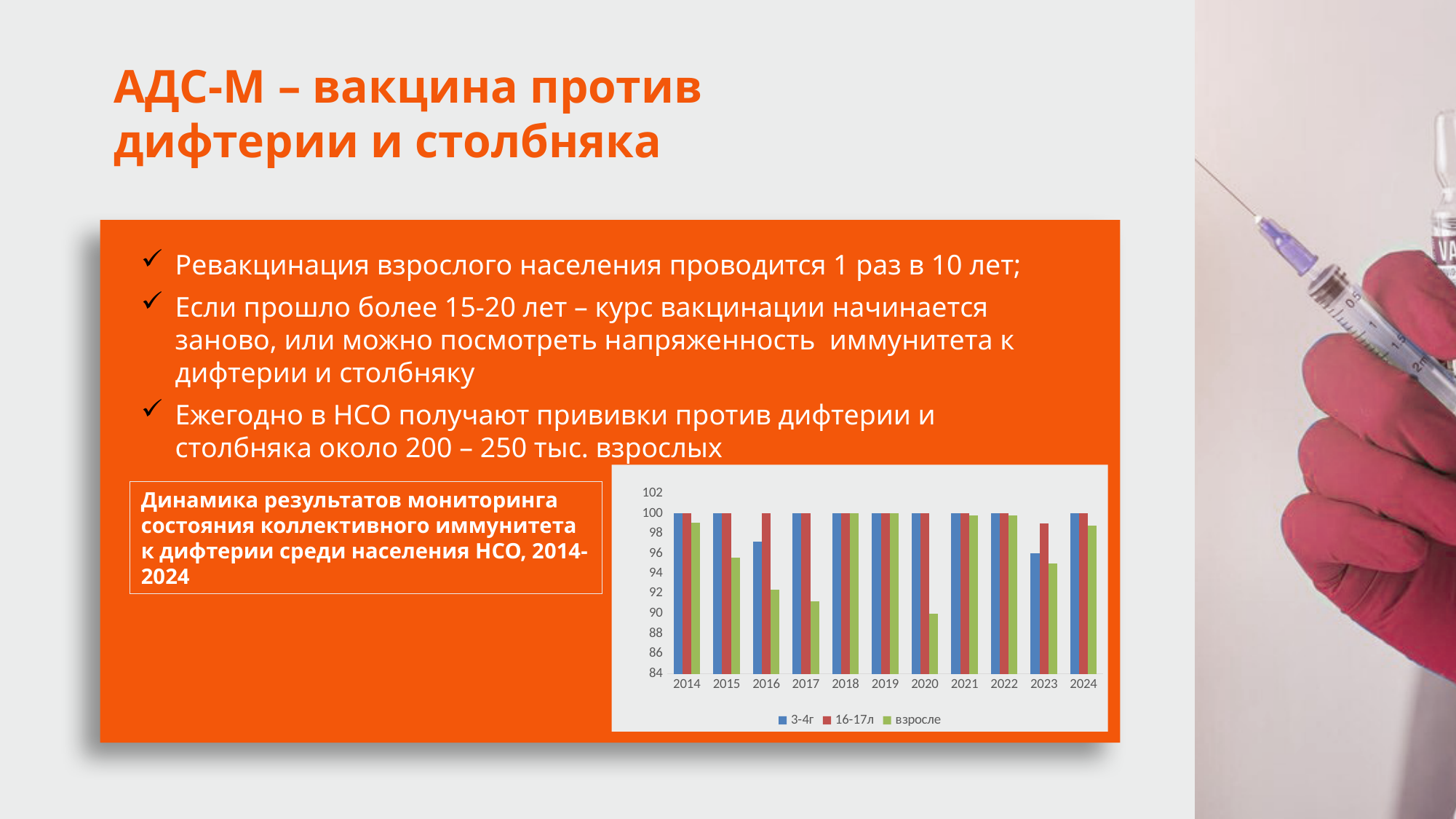
Is the value for 'взросле' in 2017 greater or less than 94? less Is the value for '3-4г' in 2023 greater or less than 98? less In 2015, which series has the smaller value: '16-17л' or 'взросле'? взросле Is the value for 'взросле' in 2020 greater or less than 92? less Which colour represents the 'взросле' series in the chart? green In 2016, which series has the larger value: '3-4г' or 'взросле'? 3-4г What kind of chart is shown on the slide? bar chart What are the series names listed in the chart legend? 3-4г, 16-17л, взросле How many years are shown on the x axis of the chart? 11 How many series does the chart legend list? 3 In 2023, which series has the larger value: '3-4г' or '16-17л'? 16-17л